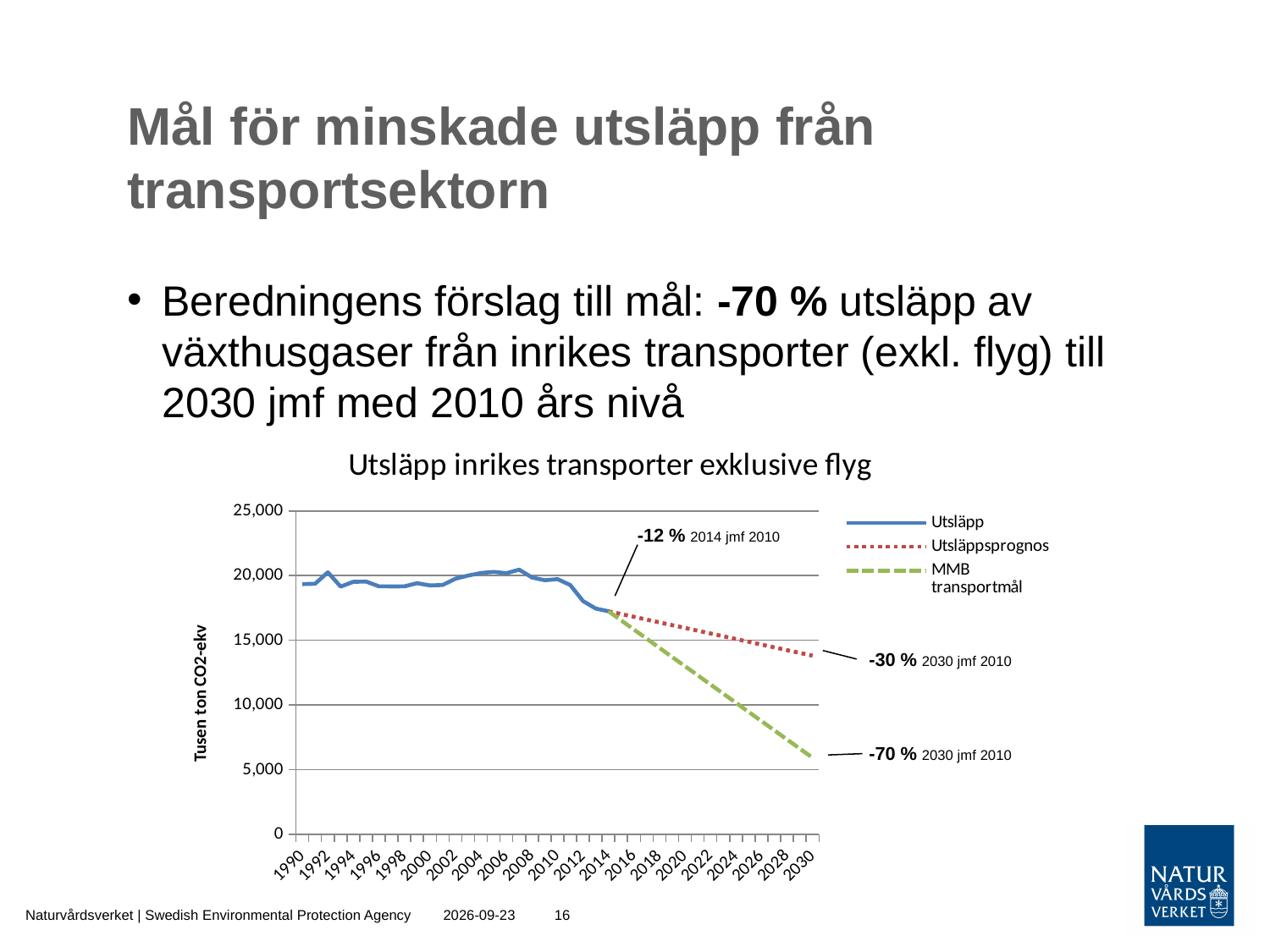
Does the MMB transportmål line rise or fall from 2014 to 2030? fall According to the annotation on the chart, what change does the Utsläppsprognos line reach in 2030 compared with 2010? -30 % Is the Utsläppsprognos value for 2030 greater or less than 15,000? less According to the annotation on the chart, what change does the MMB transportmål line reach in 2030 compared with 2010? -70 % Is the MMB transportmål value for 2030 greater or less than 10,000? less What is the label on the vertical axis of the chart? Tusen ton CO2-ekv How many series does the chart legend list? 3 Is the Utsläpp value for 2014 greater or less than 20,000? less In 2030, which is higher: the Utsläppsprognos line or the MMB transportmål line? Utsläppsprognos What kind of chart is shown on the slide? line chart What is the title of the chart? Utsläpp inrikes transporter exklusive flyg According to the annotation on the chart, what is the change in emissions in 2014 compared with 2010? -12 %